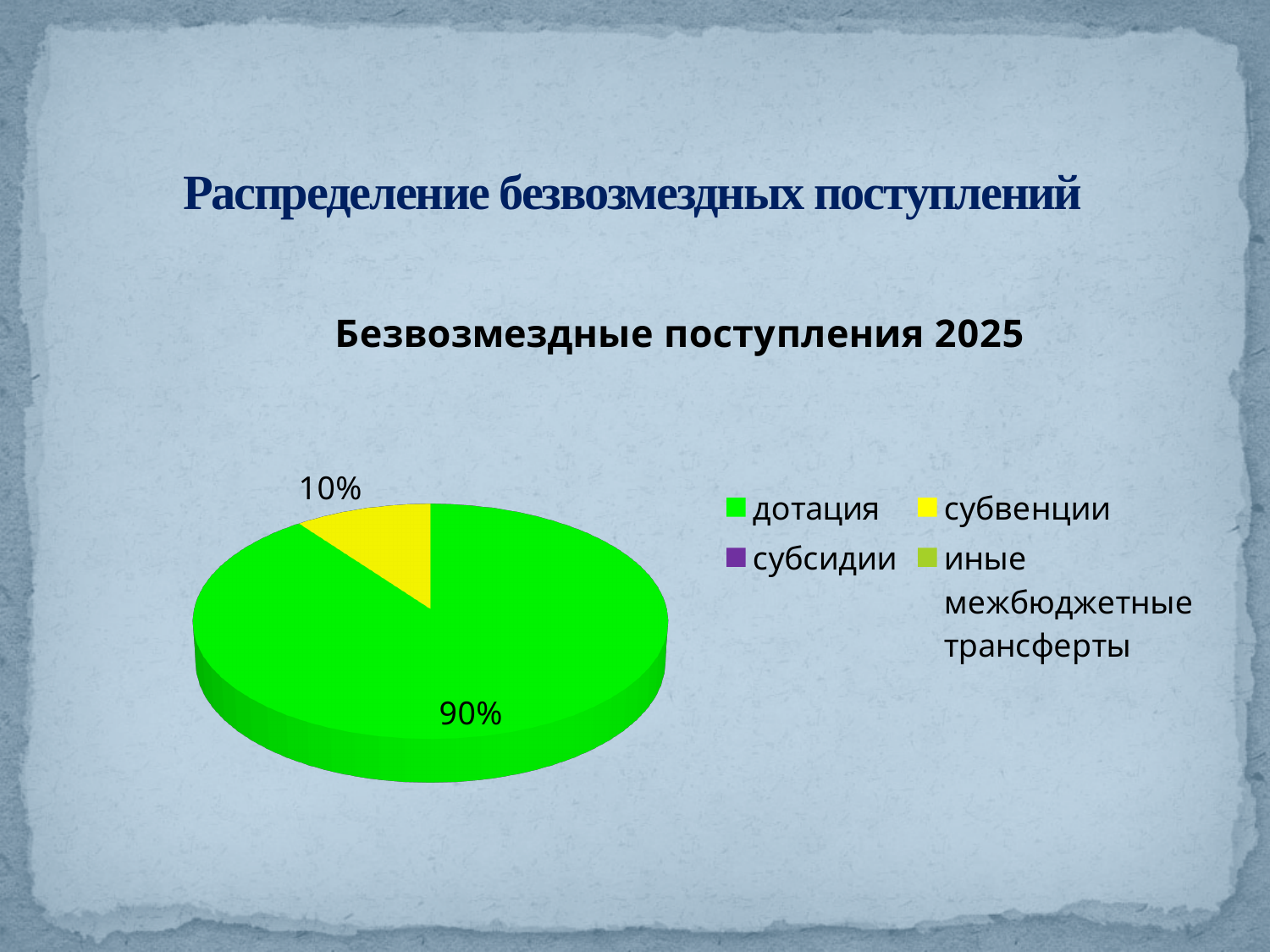
Which category has the largest slice of the pie? дотация What share of the pie does субвенции take? 10% What is the title of the chart? Безвозмездные поступления 2025 What is the value printed on the green slice? 90% What is the value printed on the yellow slice? 10% How many entries does the legend list? 4 What is the difference in percentage points between the дотация slice and the субвенции slice? 80% What colour is the slice for дотация? green Which is larger, the slice for дотация or the slice for субвенции? дотация What share of the pie does дотация take? 90% What kind of chart is shown on the slide? pie chart